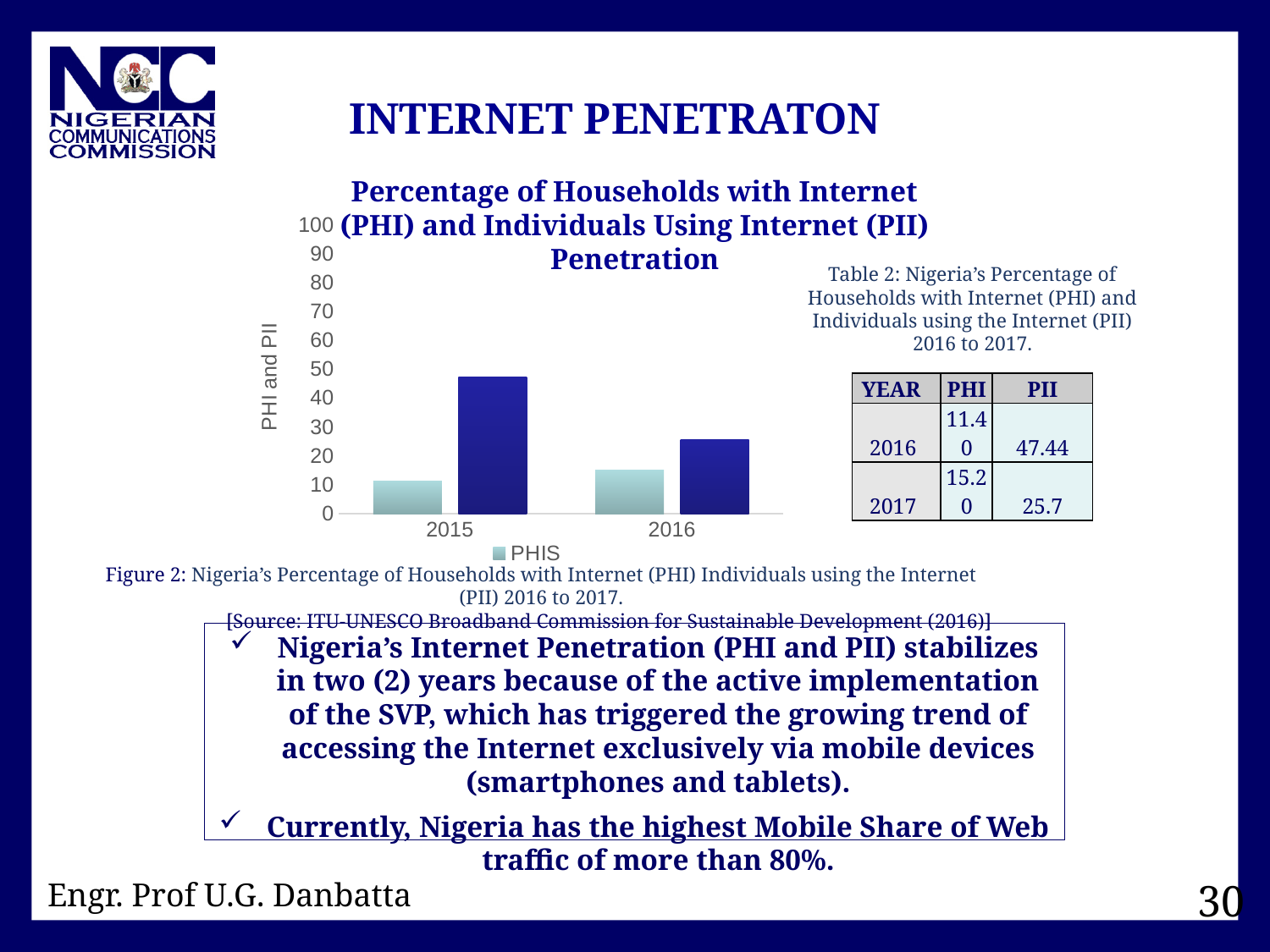
Is the value of the light blue (PHIS) bar for 2015 greater or less than 20? less Which years are shown on the x axis of the chart? 2015 and 2016 What kind of chart is shown on the slide? bar chart What series name is shown in the chart's legend? PHIS Is the value of the dark blue bar for 2016 greater or less than 30? less Which bar is the tallest in the chart? the dark blue bar for 2015 How many year categories are shown on the x axis of the chart? 2 Is the value of the dark blue bar for 2016 greater or less than 20? greater In 2015, which bar is taller, the light blue (PHIS) bar or the dark blue bar? the dark blue bar Does the dark blue series rise or fall from 2015 to 2016? fall